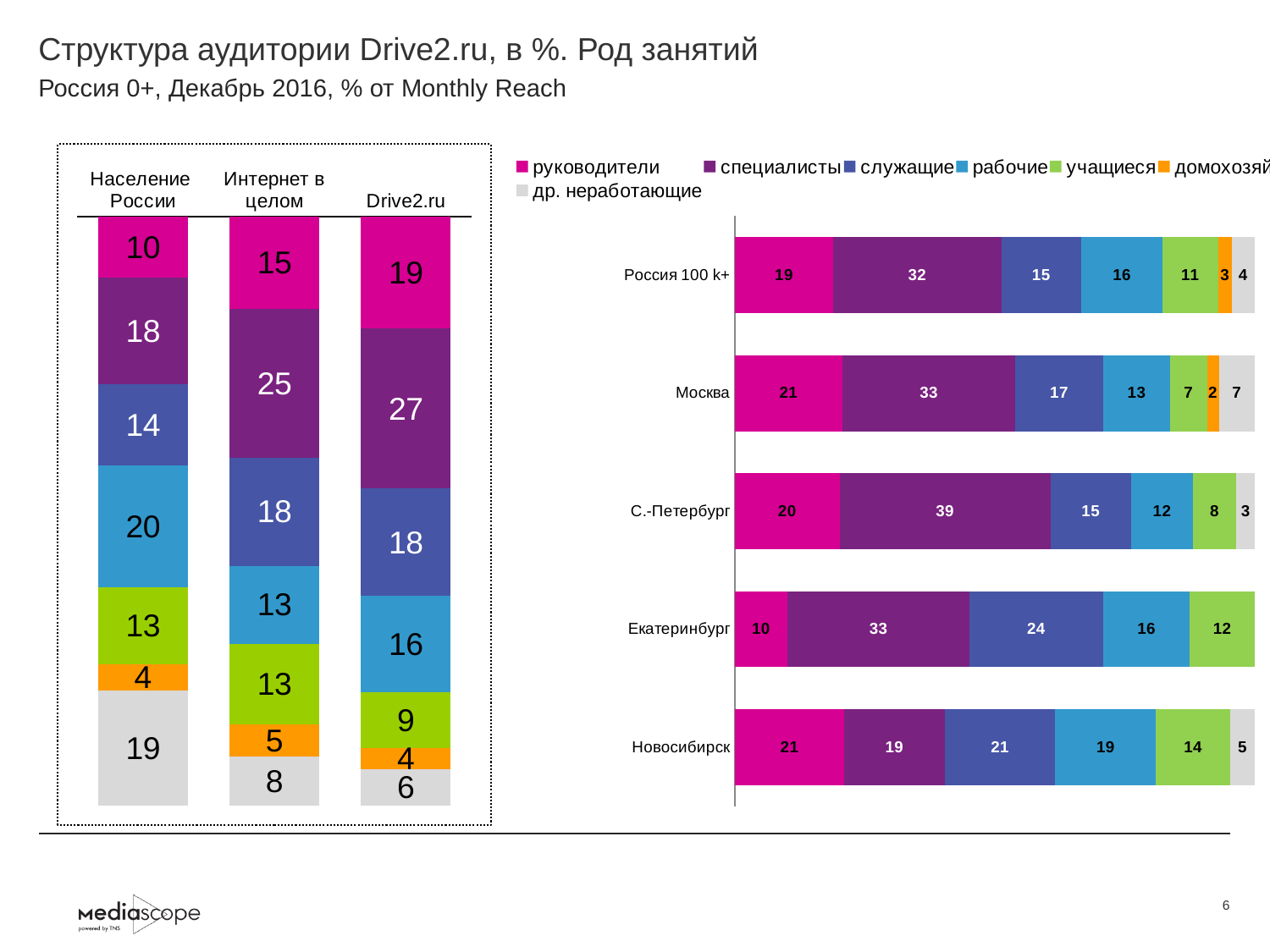
In the right chart, which city has the lowest value for руководители? Екатеринбург In the right chart, is the рабочие value larger for Новосибирск or for Москва? Новосибирск In the left chart, how many bars (categories) are shown? 3 What type of chart is the right chart? Stacked bar chart In the left chart, what is the value for др. неработающие for Интернет в целом? 8 In the left chart, what is the difference between the руководители values for Drive2.ru and Население России? 9 In the right chart, what is the value for специалисты for С.-Петербург? 39 In the left chart, what is the value for рабочие for Население России? 20 In the left chart, what is the value for специалисты for Drive2.ru? 27 In the right chart, what is the value for служащие for Екатеринбург? 24 In the right chart, how many categories (rows) are shown? 5 In the left chart, which of the three bars has the highest value for руководители? Drive2.ru